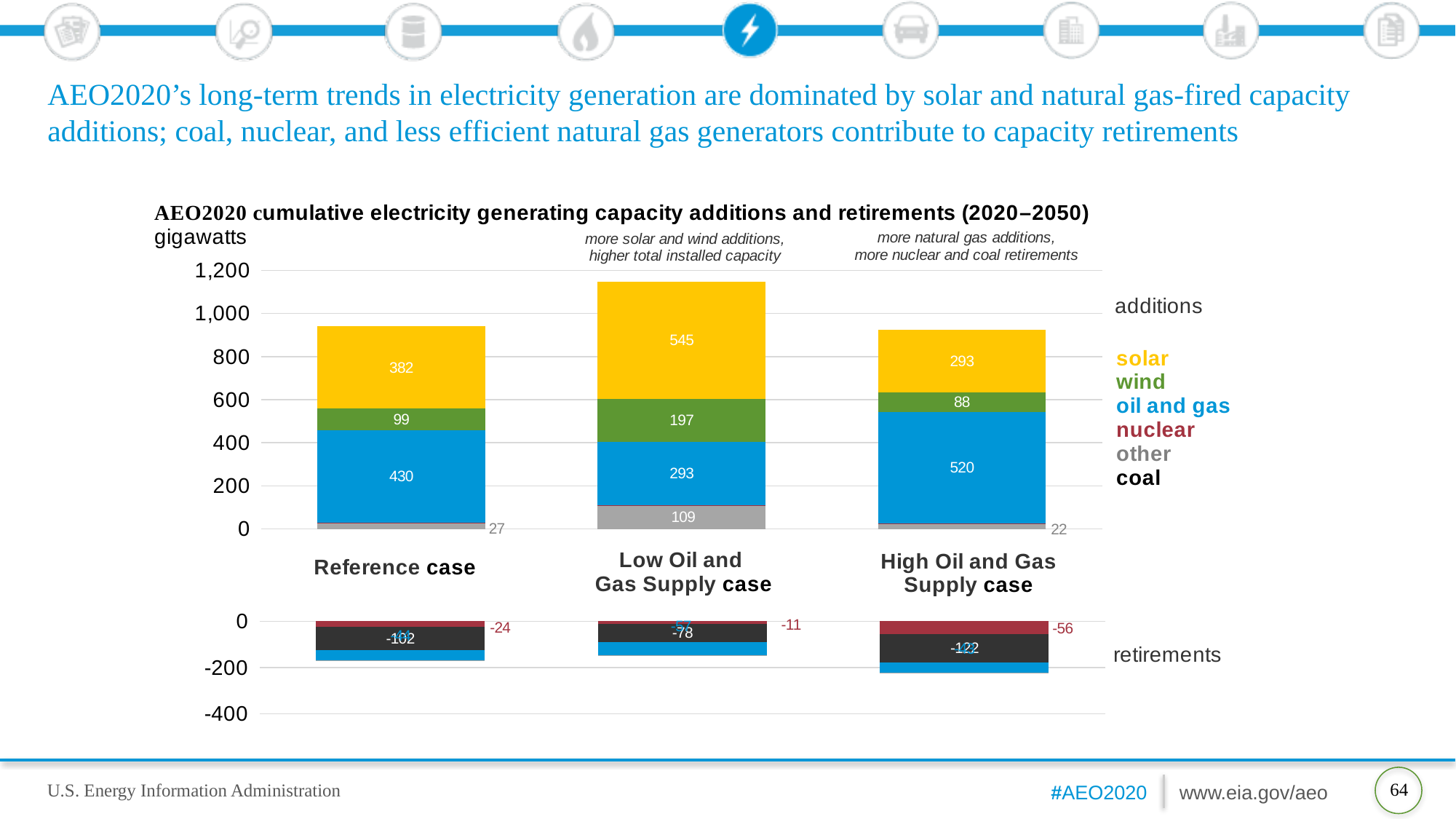
How much larger are solar additions in the Low Oil and Gas Supply case than in the Reference case? 163 Which case has the lowest wind capacity additions? High Oil and Gas Supply case How many cases (categories) are shown along the x axis of the chart? 3 What are the nuclear retirements in the Low Oil and Gas Supply case? -11 What are the coal retirements in the High Oil and Gas Supply case? -122 What are the oil and gas capacity additions in the High Oil and Gas Supply case? 520 Are total capacity additions in the Low Oil and Gas Supply case greater or less than 1,000 gigawatts? greater Which case has the highest solar capacity additions? Low Oil and Gas Supply case What are the wind capacity additions in the Low Oil and Gas Supply case? 197 What are the solar capacity additions in the Reference case? 382 What type of chart is shown on the slide? bar chart How many series does the legend list? 6